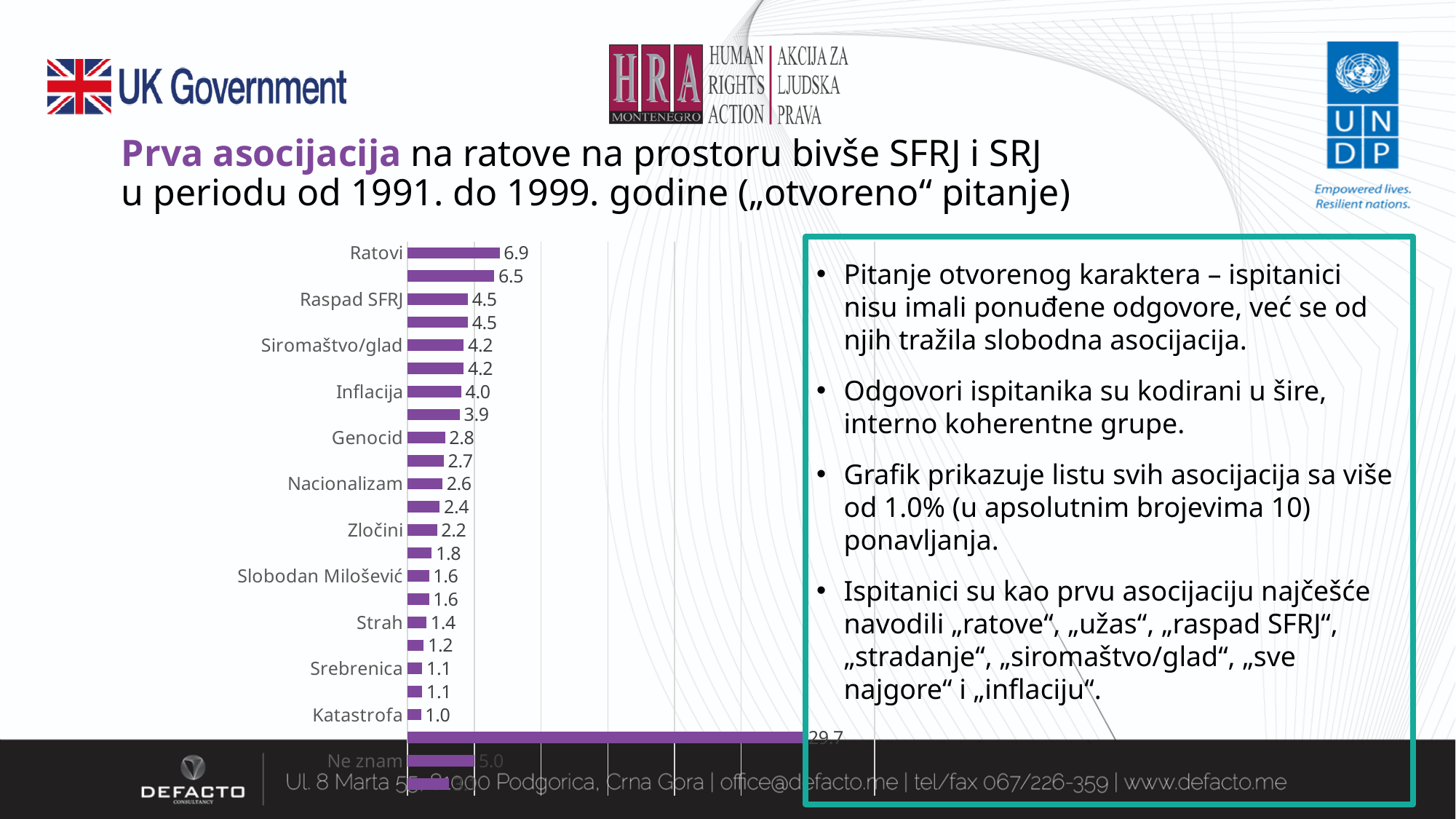
What kind of chart is shown on the slide? Bar chart What is the value for Ne znam? 5.0 What is the value for Raspad SFRJ? 4.5 What is the difference between the values for Ratovi and Raspad SFRJ? 2.4 What is the value for Inflacija? 4.0 What is the value for Ratovi? 6.9 What is the value for Genocid? 2.8 Which has a larger value, Inflacija or Zločini? Inflacija What is the value for Srebrenica? 1.1 What is the value for Slobodan Milošević? 1.6 What is the value for Siromaštvo/glad? 4.2 What colour are the bars in the chart? Purple